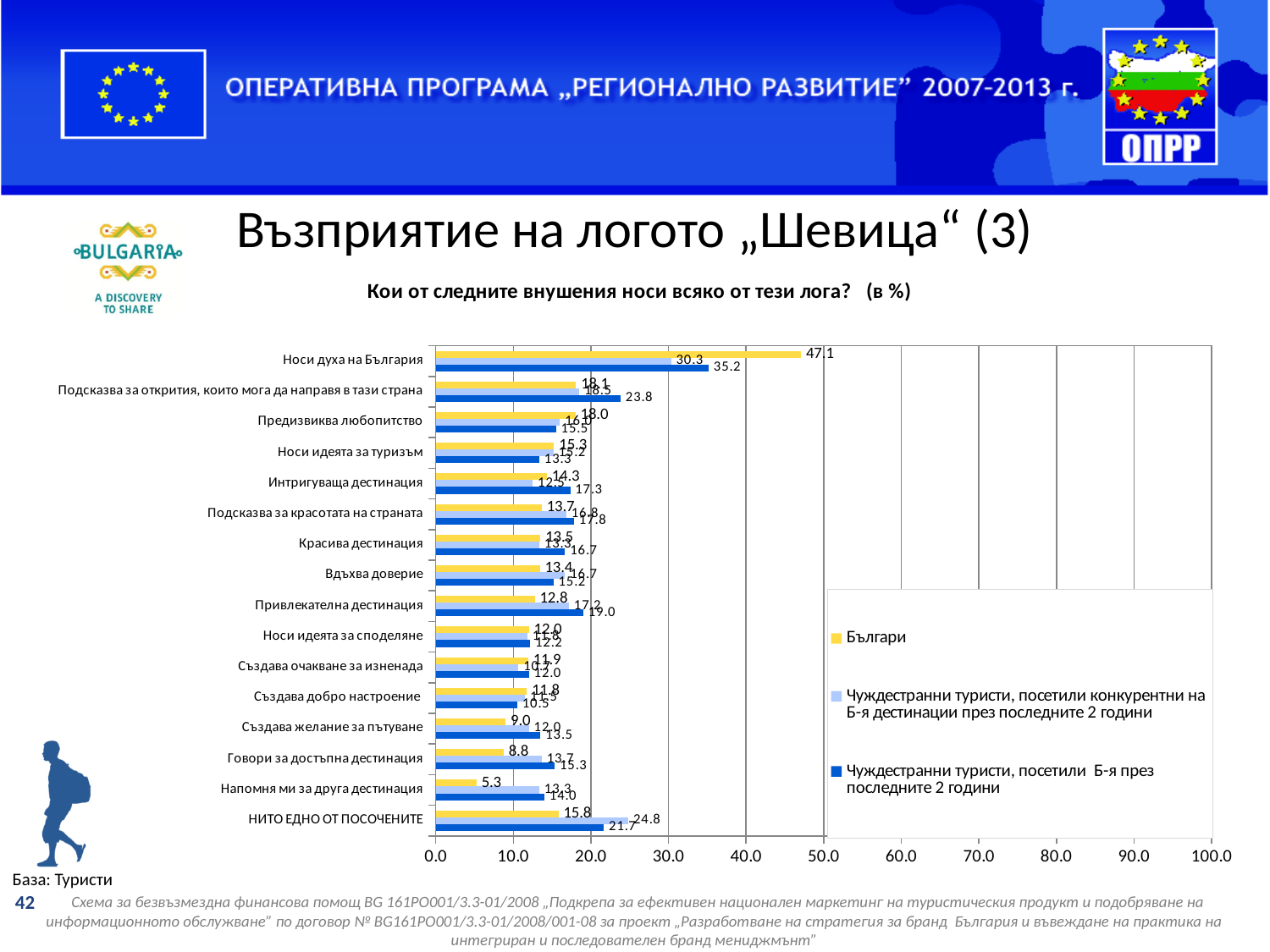
For "НИТО ЕДНО ОТ ПОСОЧЕНИТЕ", which series has the larger value: "Чуждестранни туристи, посетили конкурентни на Б-я дестинации през последните 2 години" or "Чуждестранни туристи, посетили Б-я през последните 2 години"? Чуждестранни туристи, посетили конкурентни на Б-я дестинации през последните 2 години Is the Българи value for "Носи духа на България" greater or less than 40.0? greater How many categories are plotted on the vertical axis? 16 What kind of chart is shown on the slide? bar chart What is the value for "Чуждестранни туристи, посетили конкурентни на Б-я дестинации през последните 2 години" for "НИТО ЕДНО ОТ ПОСОЧЕНИТЕ"? 24.8 Which category has the highest value for Българи? Носи духа на България How many series does the legend list? 3 What is the value for "Чуждестранни туристи, посетили Б-я през последните 2 години" for "Носи духа на България"? 35.2 For "Носи духа на България", what is the difference between the Българи value and the value for "Чуждестранни туристи, посетили Б-я през последните 2 години"? 11.9 Which category has the lowest value for Българи? Напомня ми за друга дестинация What is the value for Българи for "Носи духа на България"? 47.1 What is the value for Българи for "Напомня ми за друга дестинация"? 5.3